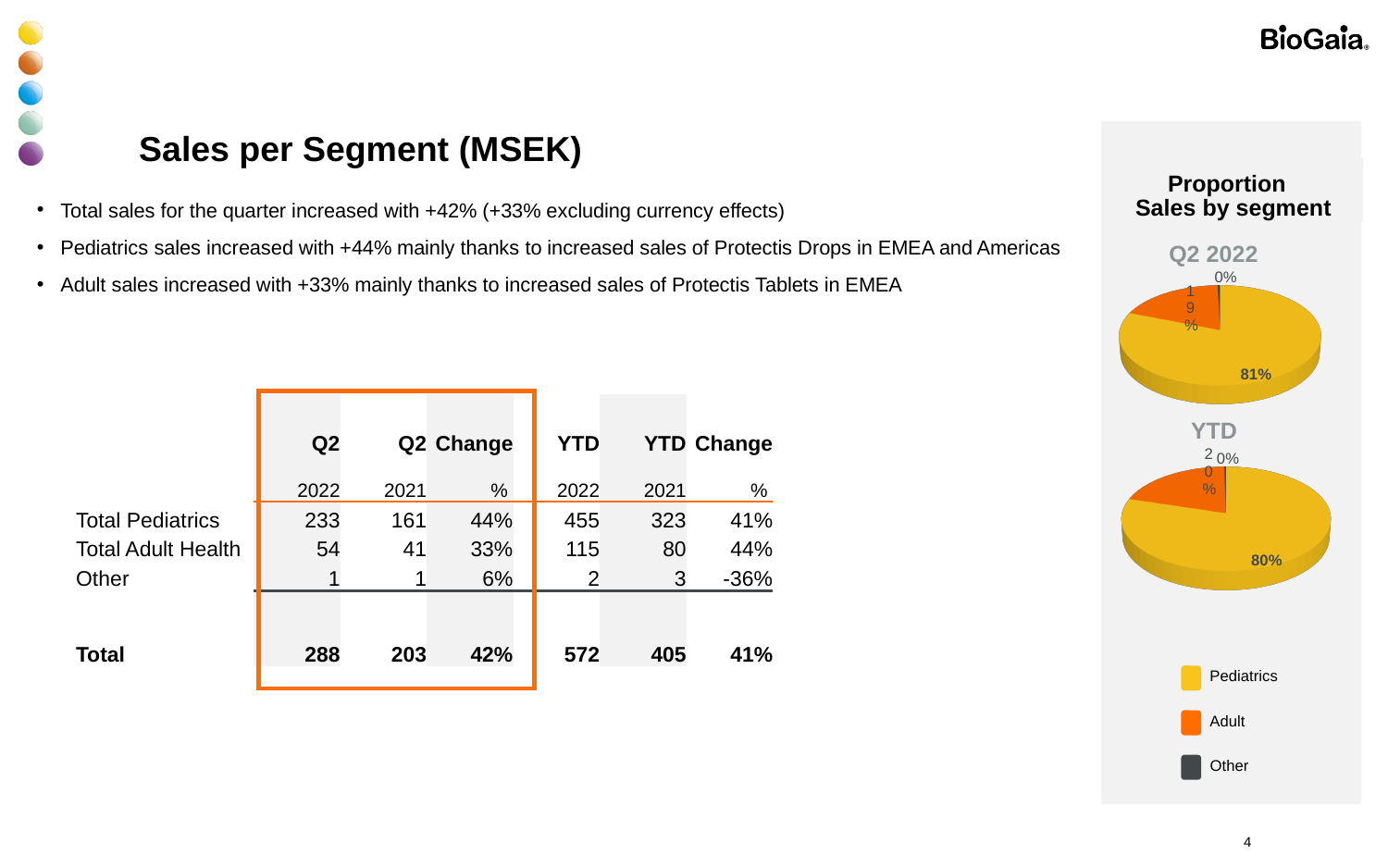
In the Q2 2022 pie chart, which is larger, the Pediatrics slice or the Adult slice? Pediatrics What colour represents Pediatrics in the pie charts? Yellow In the Q2 2022 pie chart, what share of sales does Other account for? 0% In the Q2 2022 pie chart, what share of sales does Pediatrics account for? 81% In the YTD pie chart, what share of sales does Pediatrics account for? 80% In the YTD pie chart, what share of sales does Adult account for? 20% What kind of charts are shown on the right side of the slide? Pie charts How many segments does the legend of the pie charts list? 3 In the Q2 2022 pie chart, which segment has the largest slice? Pediatrics What is the difference in percentage points between the Pediatrics share in Q2 2022 and the Pediatrics share YTD? 1 percentage point In the YTD pie chart, which segment has the smallest slice? Other